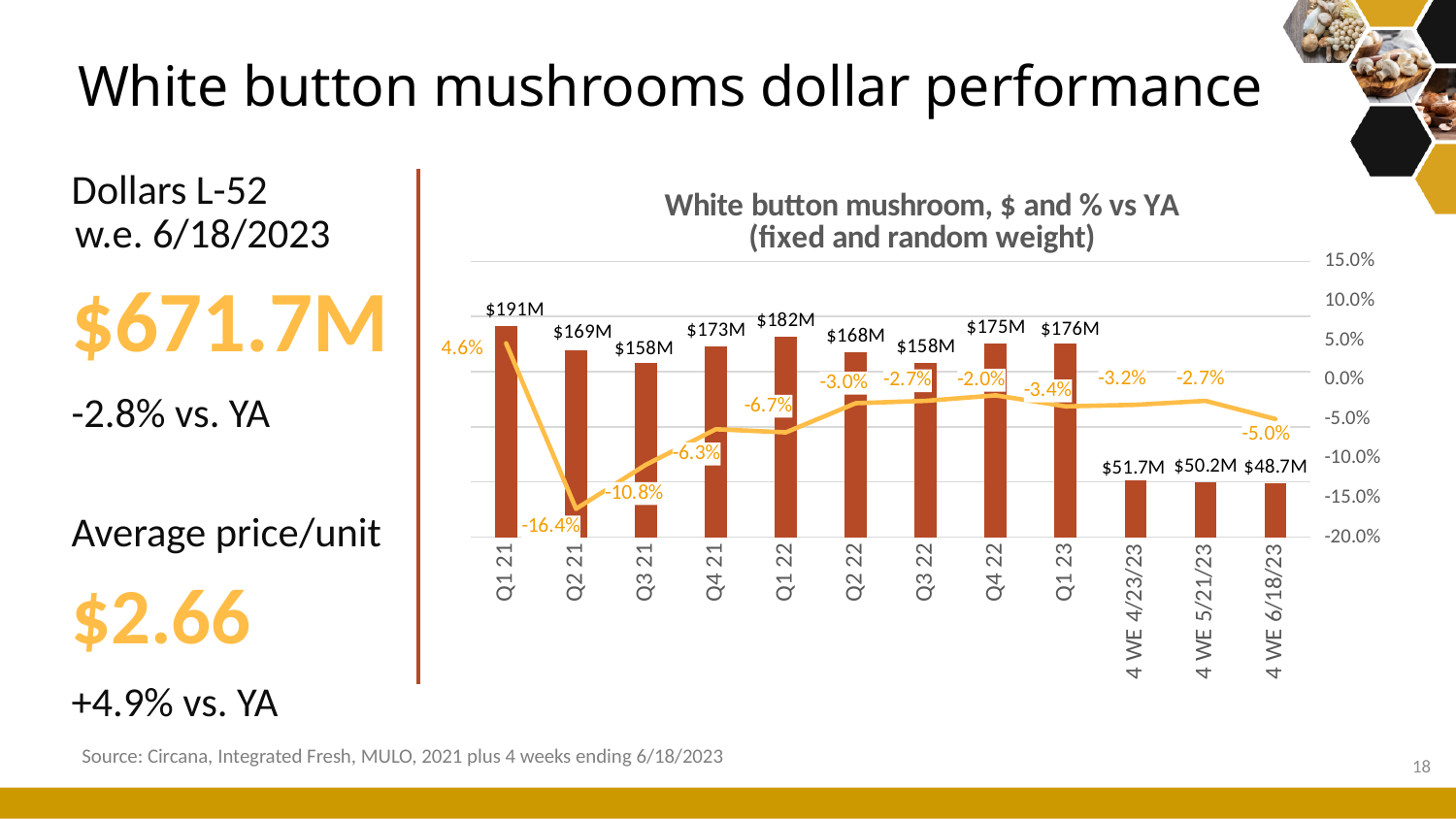
What is the % vs YA value shown for Q2 21? -16.4% What is the dollar value shown for Q1 21? $191M What is the title of the chart? White button mushroom, $ and % vs YA (fixed and random weight) Which period has the highest dollar value? Q1 21 How many periods are shown on the x axis? 12 Which is larger, the dollar value for Q4 22 or Q1 23? Q1 23 Which period has the lowest % vs YA value? Q2 21 What is the dollar value shown for the 4 WE 6/18/23 period? $48.7M What is the difference in dollars between Q1 22 and Q2 22? $14M What is the % vs YA value shown for Q4 22? -2.0% What kind of chart is this? Combination bar and line chart Does the % vs YA line rise or fall from Q2 21 to Q4 22? Rise